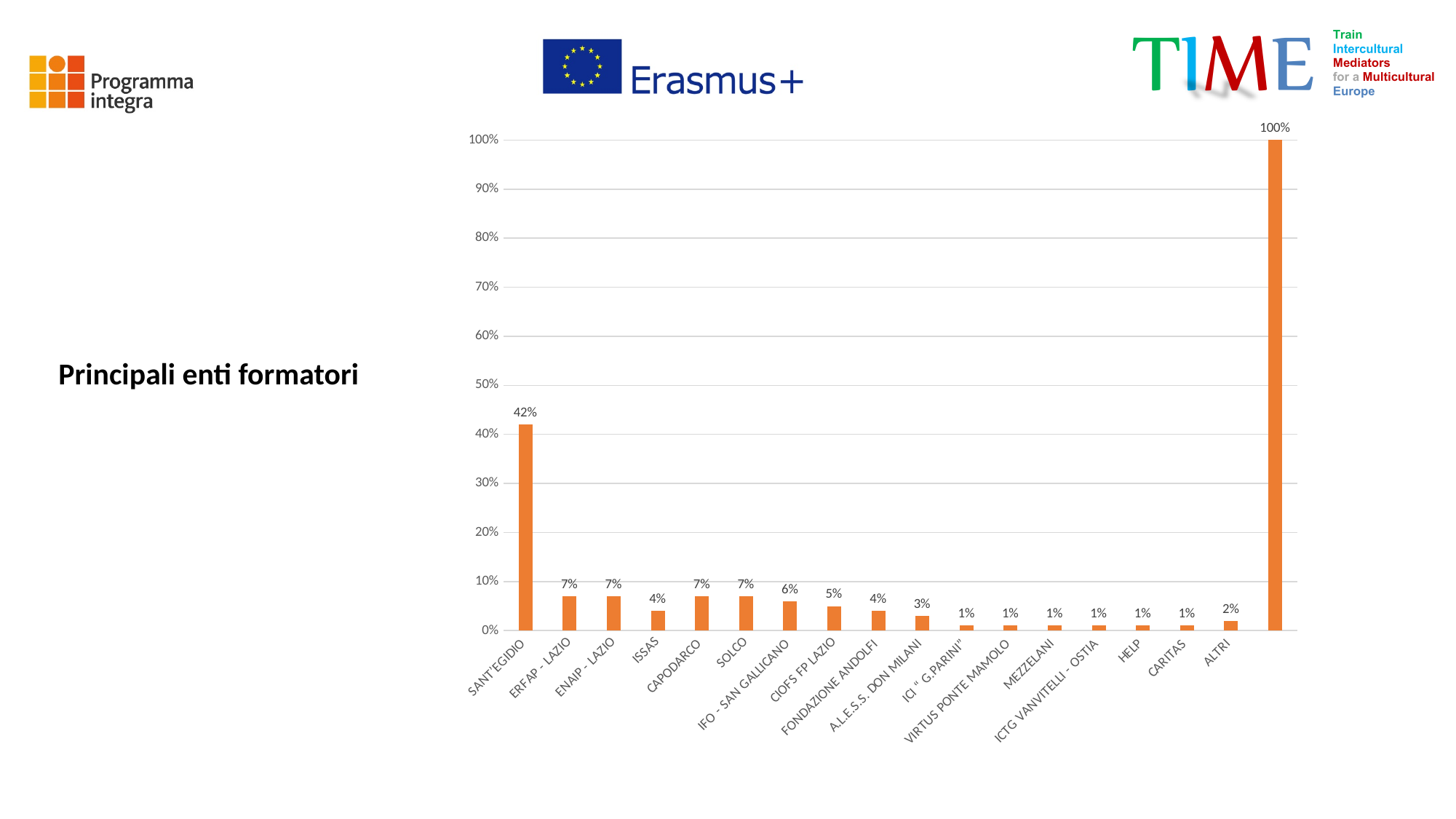
What is the value for ALTRI? 2% What is the value for CARITAS? 1% Is the value for SANT'EGIDIO greater or less than 40%? greater What is the value for A.L.E.S.S. DON MILANI? 3% What is the value for CIOFS FP LAZIO? 5% Which is larger, the value for ISSAS or the value for CAPODARCO? CAPODARCO What kind of chart is shown on the slide? bar chart Among the labeled categories, which has the highest value? SANT'EGIDIO What is the difference between the values for SANT'EGIDIO and ERFAP - LAZIO? 35% What is the title text shown to the left of the chart? Principali enti formatori What is the value for IFO - SAN GALLICANO? 6% What is the value for SANT'EGIDIO? 42%